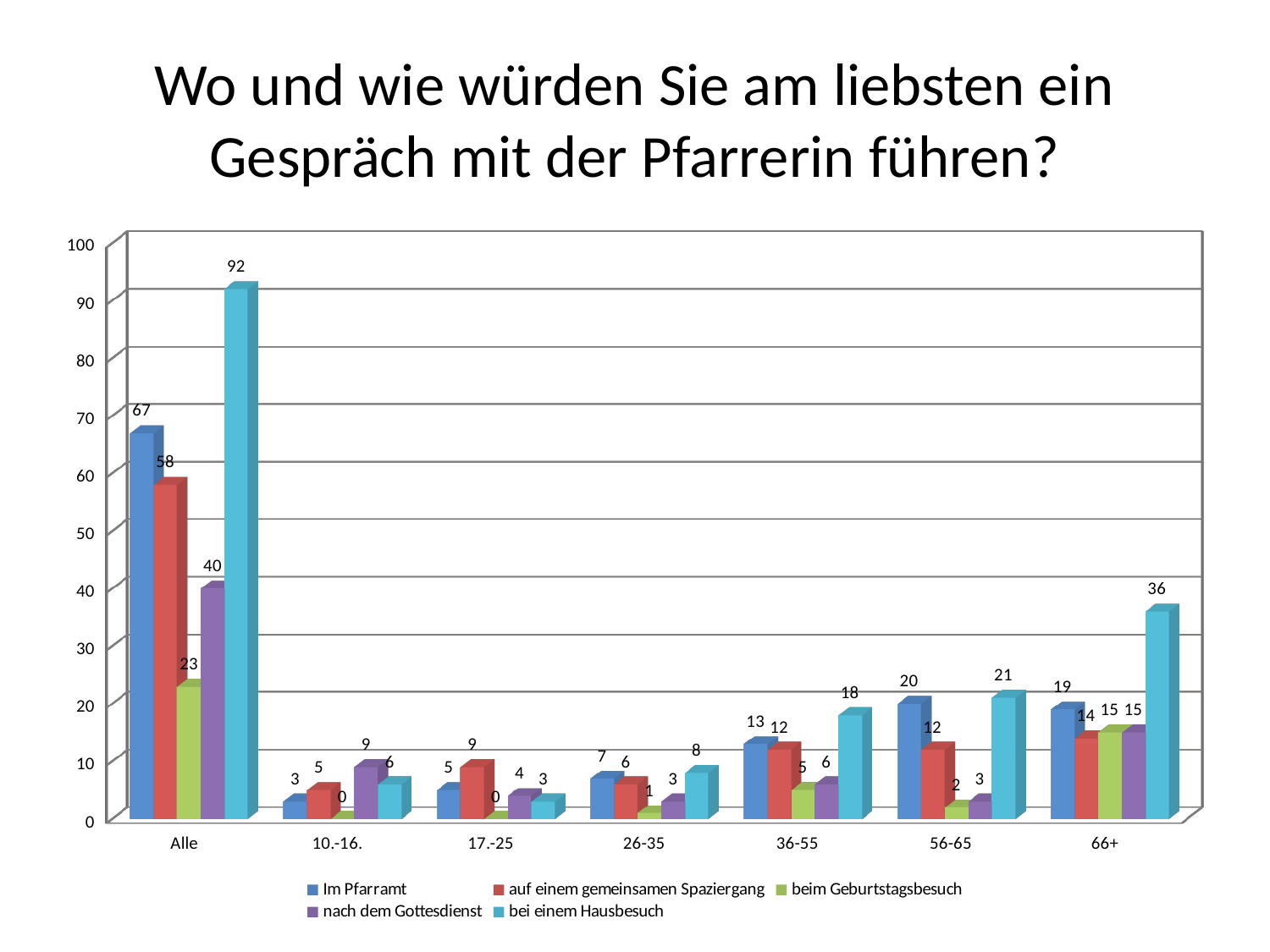
Which series has the highest value in the '17.-25' category? auf einem gemeinsamen Spaziergang Which is larger in the '36-55' category: 'Im Pfarramt' or 'bei einem Hausbesuch'? bei einem Hausbesuch How many series does the legend list? 5 What kind of chart is shown on the slide? bar chart What is the value for 'bei einem Hausbesuch' in the 'Alle' category? 92 What is the title of the slide? Wo und wie würden Sie am liebsten ein Gespräch mit der Pfarrerin führen? What is the difference between 'bei einem Hausbesuch' and 'Im Pfarramt' in the 'Alle' category? 25 Is the value for 'nach dem Gottesdienst' in the 'Alle' category greater or less than 30? greater What is the value for 'beim Geburtstagsbesuch' in the '66+' category? 15 How many age categories are shown on the x axis? 7 Which series has the lowest value in the '10.-16.' category? beim Geburtstagsbesuch What is the value for 'Im Pfarramt' in the '56-65' category? 20